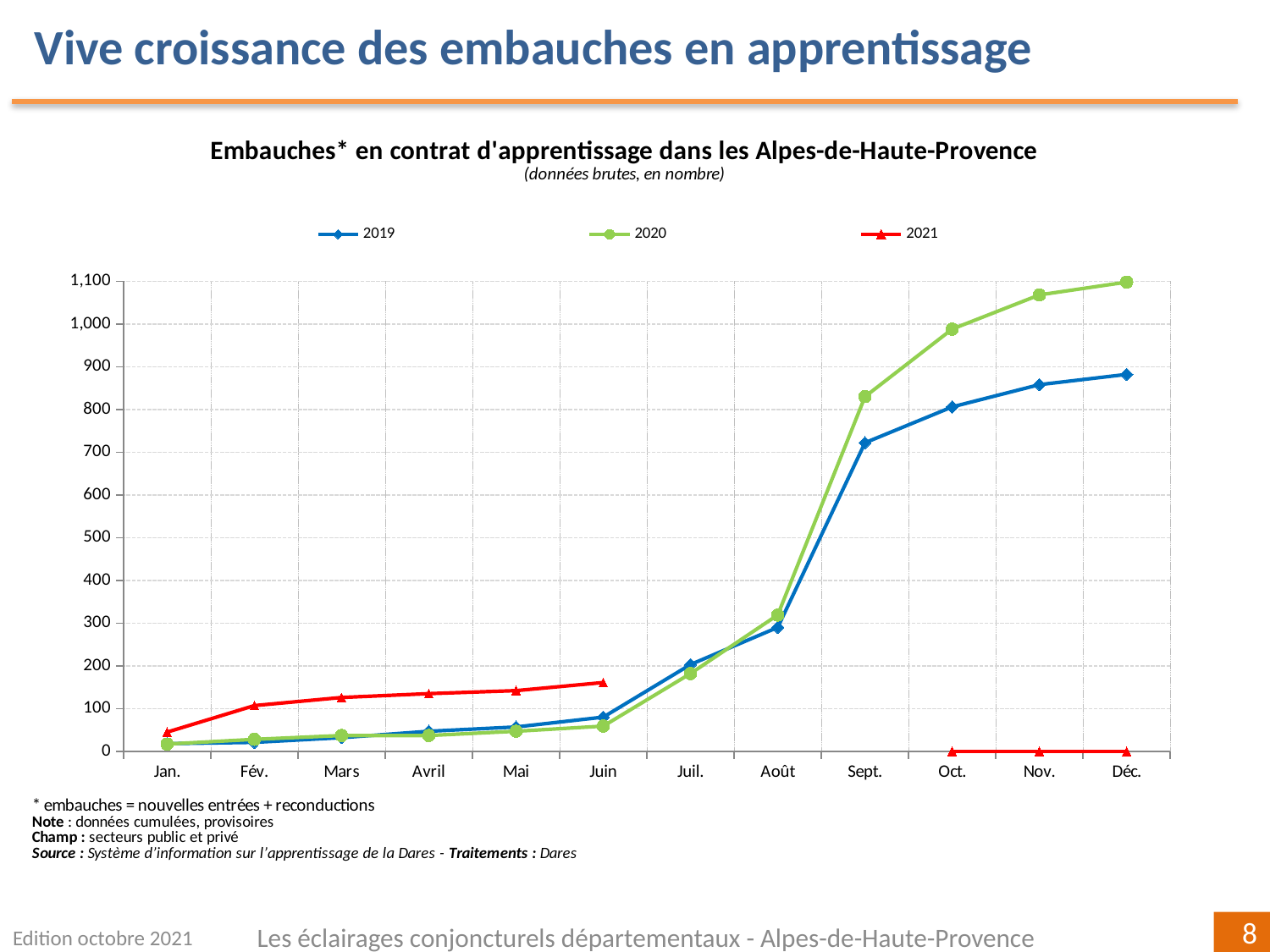
Is the value for 2021 in Juin greater or less than 100? greater Is the value for 2021 in Jan. greater or less than 100? less Is the value for 2019 in Juin greater or less than 200? less What kind of chart is shown on the slide? line chart Which series has the higher value in Mars, 2019 or 2021? 2021 Do the values for the 2020 series rise or fall from Jan. to Déc.? rise Which series has the higher value in Déc., 2019 or 2020? 2020 How many months are shown along the x axis? 12 In which month does the 2020 series reach its highest value? Déc. How many series does the legend list? 3